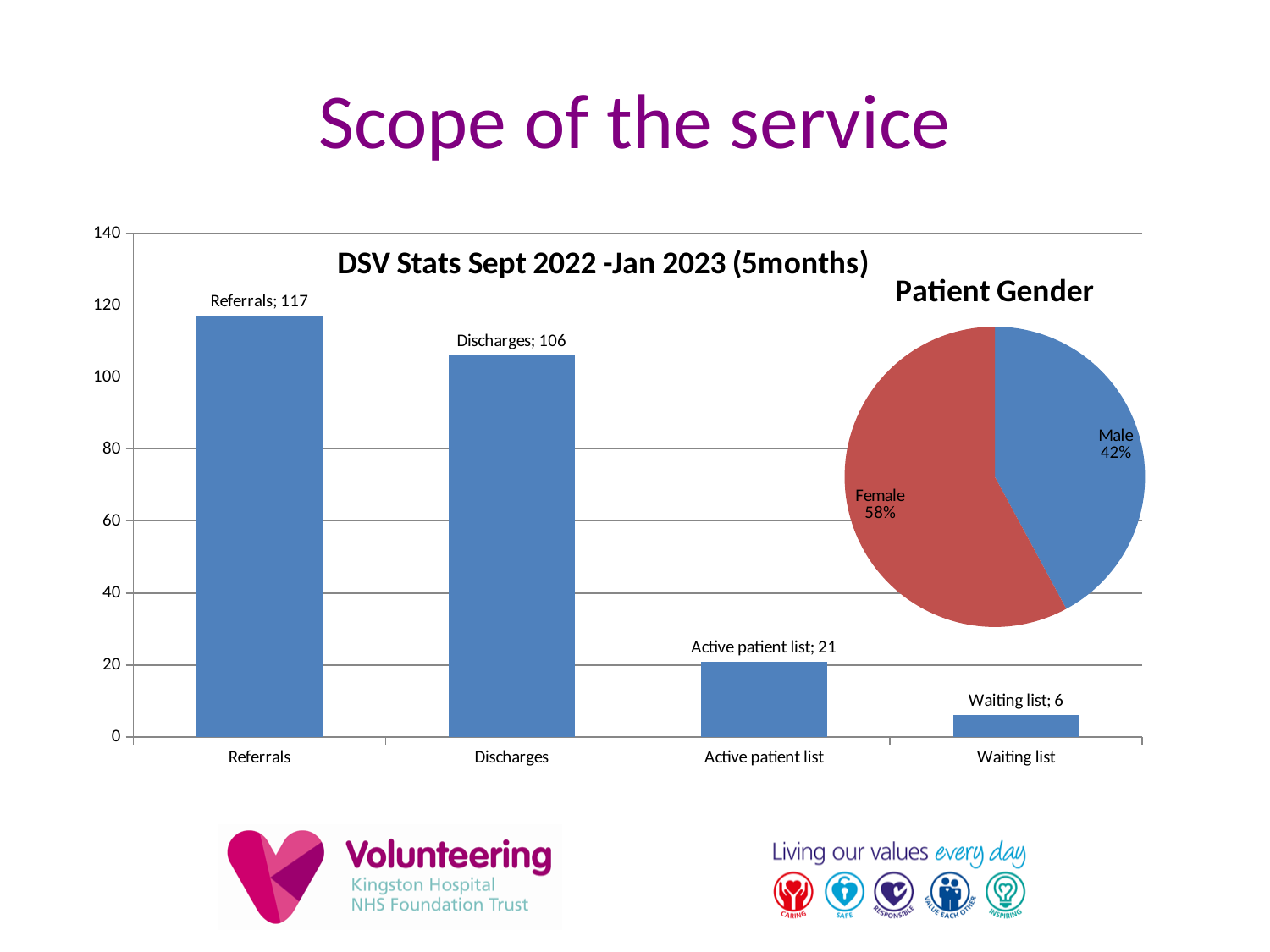
In the 'Patient Gender' chart, what share of patients is Male? 42% What kind of chart is the 'Patient Gender' chart? Pie chart In the 'DSV Stats Sept 2022 -Jan 2023 (5months)' chart, how many categories are shown? 4 In the 'DSV Stats Sept 2022 -Jan 2023 (5months)' chart, what is the difference between Referrals and Discharges? 11 In the 'DSV Stats Sept 2022 -Jan 2023 (5months)' chart, which is larger, Active patient list or Waiting list? Active patient list In the 'DSV Stats Sept 2022 -Jan 2023 (5months)' chart, what is the value for Discharges? 106 In the 'DSV Stats Sept 2022 -Jan 2023 (5months)' chart, which category has the lowest value? Waiting list In the 'DSV Stats Sept 2022 -Jan 2023 (5months)' chart, which category has the highest value? Referrals What kind of chart is the 'DSV Stats Sept 2022 -Jan 2023 (5months)' chart? Bar chart In the 'DSV Stats Sept 2022 -Jan 2023 (5months)' chart, what is the value for Referrals? 117 In the 'Patient Gender' chart, what share of patients is Female? 58% In the 'DSV Stats Sept 2022 -Jan 2023 (5months)' chart, what is the value for Waiting list? 6